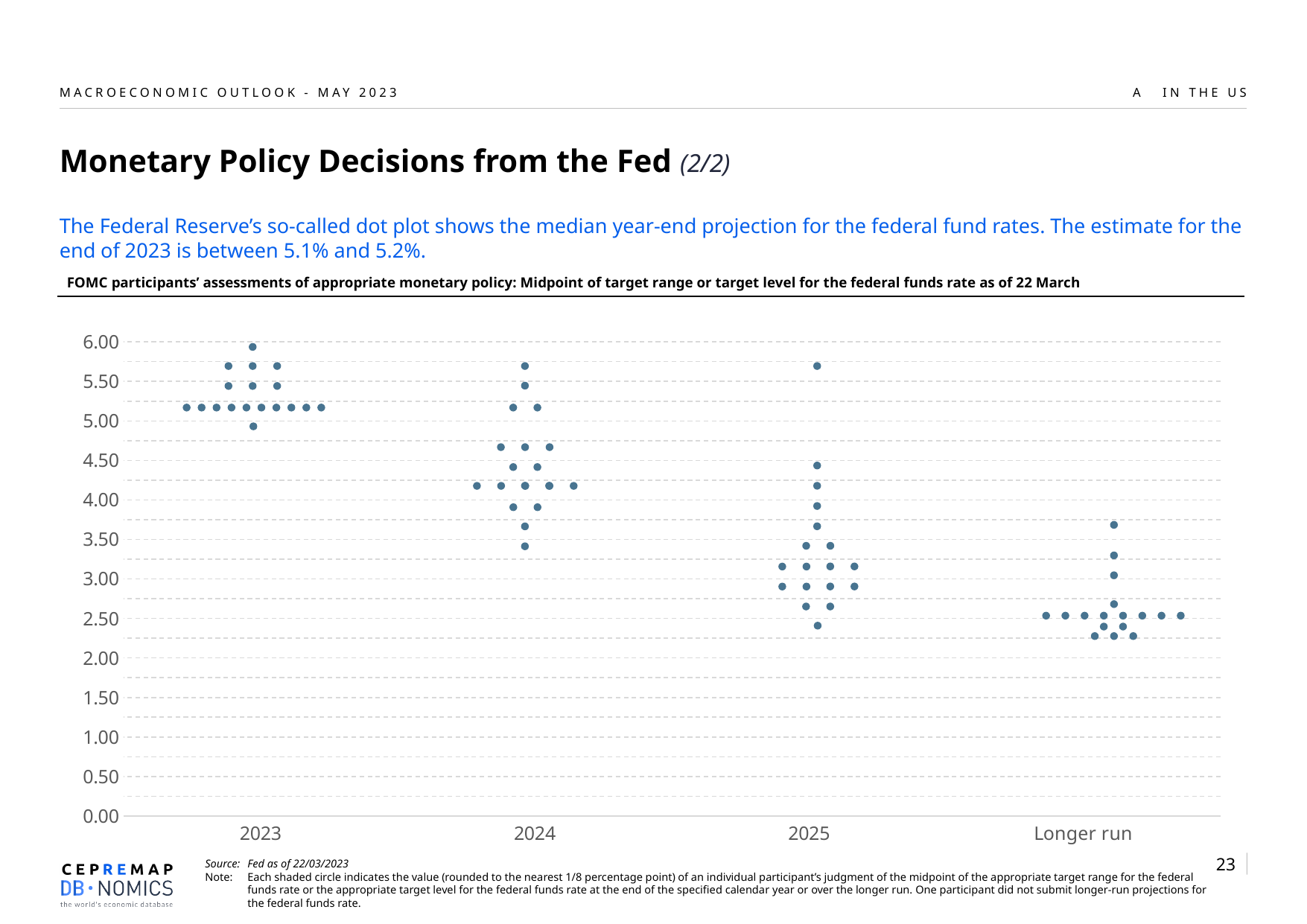
What kind of chart is shown on the slide? Dot plot (scatter chart) What is the label of the last category on the x axis of the chart? Longer run Is the lowest dot for 2024 greater or less than 3.00? greater Which category on the x axis contains the highest dot in the chart? 2023 Is the highest dot for Longer run greater or less than 4.00? less Is the lowest dot for Longer run greater or less than 2.50? less Which category has dots at higher values overall, 2023 or 2025? 2023 How many categories are shown on the x axis of the chart? 4 Do the dots generally rise or fall moving from 2023 to Longer run along the x axis? fall Which category on the x axis contains the lowest dot in the chart? Longer run